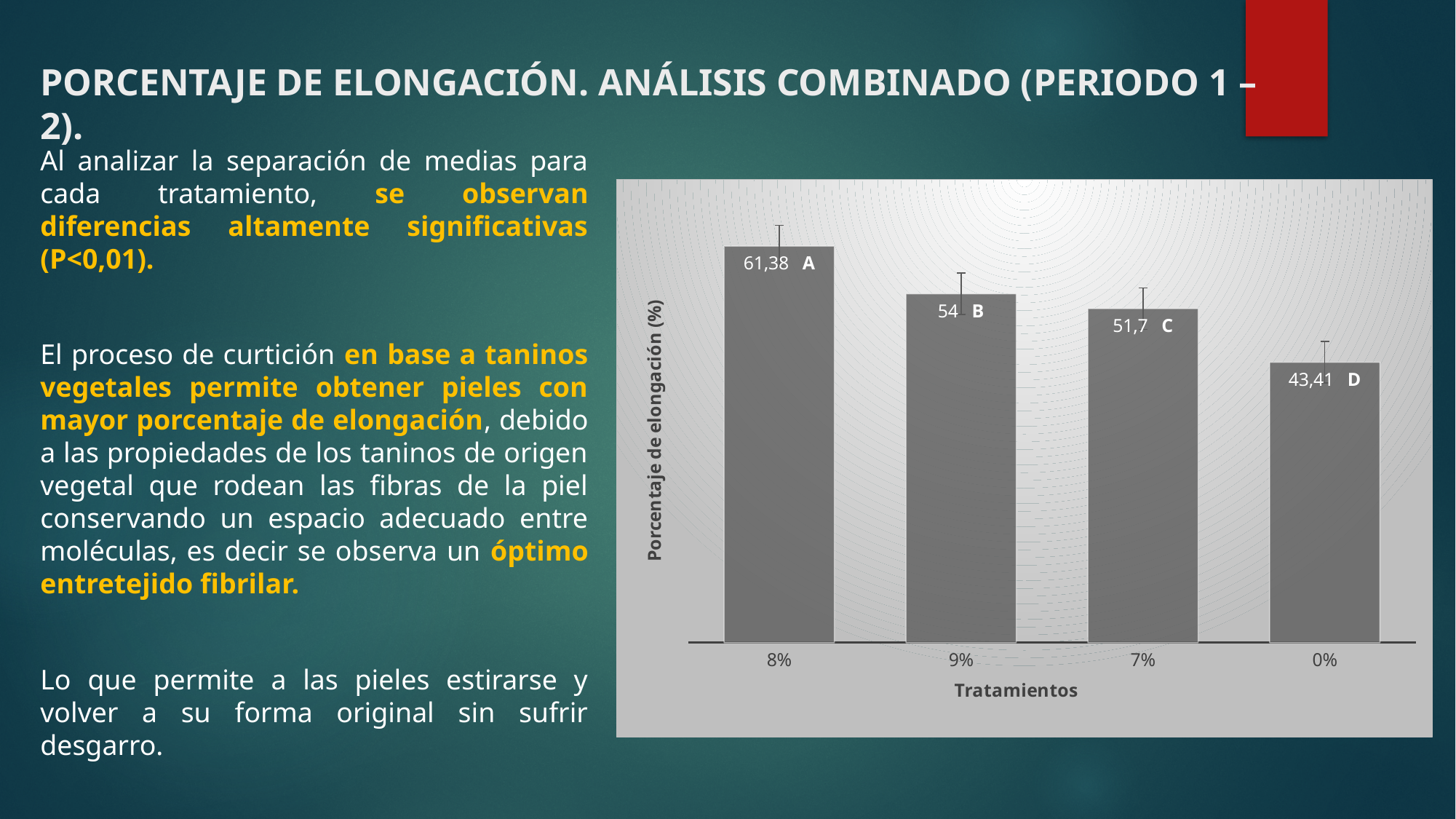
What type of chart is shown on the slide? Bar chart Which has a higher elongation percentage, the 9% treatment or the 0% treatment? 9% What is the elongation percentage for the 7% treatment? 51,7 How many treatments are shown in the chart? 4 What is the difference between the elongation percentage of the 8% treatment and the 0% treatment? 17,97 What is the difference between the elongation percentage of the 9% treatment and the 7% treatment? 2,3 What is the elongation percentage for the 8% treatment? 61,38 What is the elongation percentage for the 9% treatment? 54 What is the elongation percentage for the 0% treatment? 43,41 Which treatment has the lowest elongation percentage? 0% Which treatment has the highest elongation percentage? 8% Do the elongation values rise or fall from left to right along the x axis? Fall